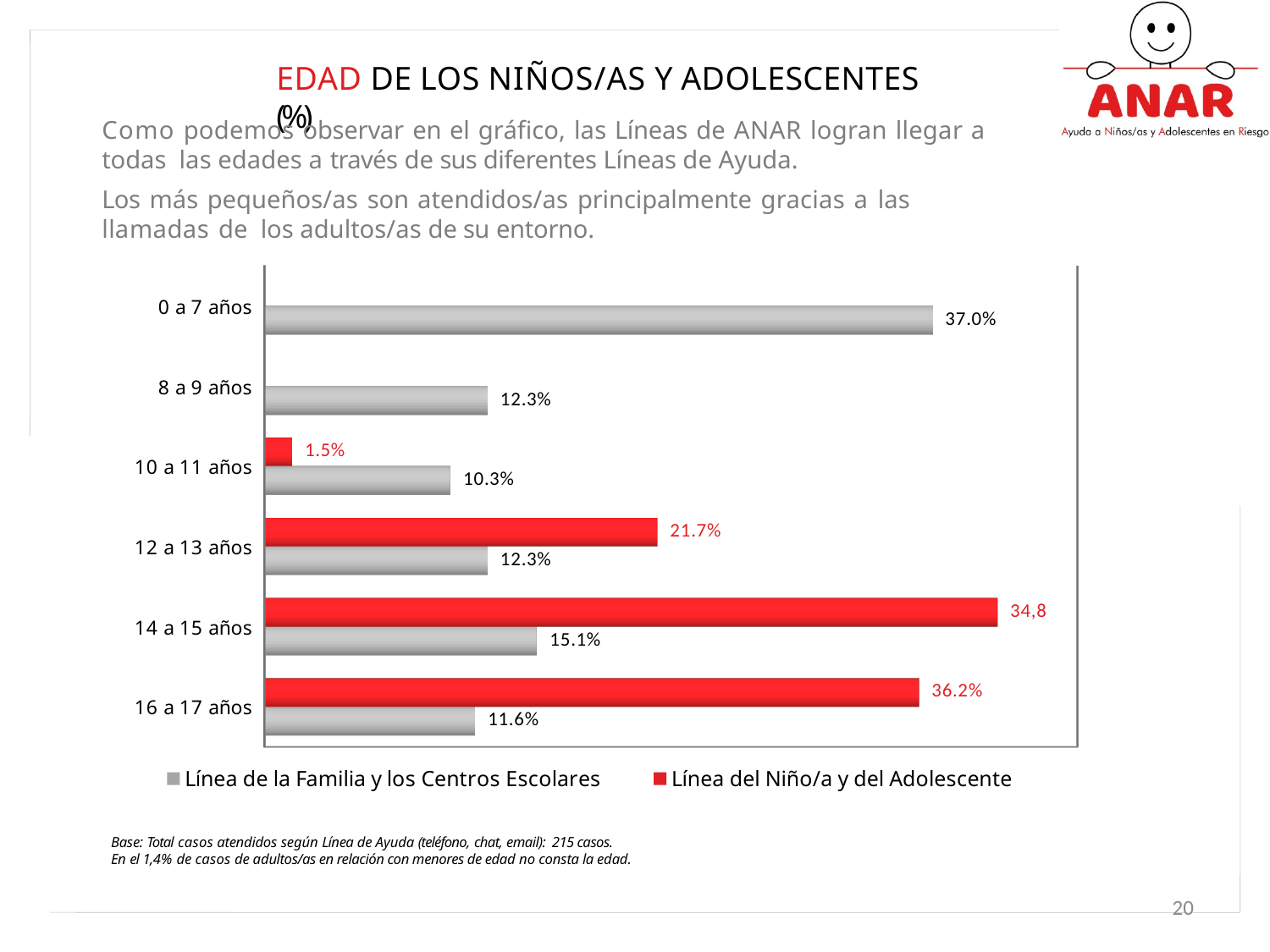
For 16 a 17 años, which series has the larger value: Línea de la Familia y los Centros Escolares or Línea del Niño/a y del Adolescente? Línea del Niño/a y del Adolescente What is the value for 10 a 11 años in the Línea del Niño/a y del Adolescente series? 1.5% How many age groups are shown on the chart? 6 How many series does the legend list? 2 What is the value for 16 a 17 años in the Línea del Niño/a y del Adolescente series? 36.2% What is the value for 14 a 15 años in the Línea de la Familia y los Centros Escolares series? 15.1% Which age group has the lowest value in the Línea de la Familia y los Centros Escolares series? 10 a 11 años What kind of chart is shown on the slide? Bar chart Which age group has the highest value in the Línea de la Familia y los Centros Escolares series? 0 a 7 años What is the value for 0 a 7 años in the Línea de la Familia y los Centros Escolares series? 37.0% What is the difference between the Línea del Niño/a y del Adolescente value and the Línea de la Familia y los Centros Escolares value for 12 a 13 años? 9.4%